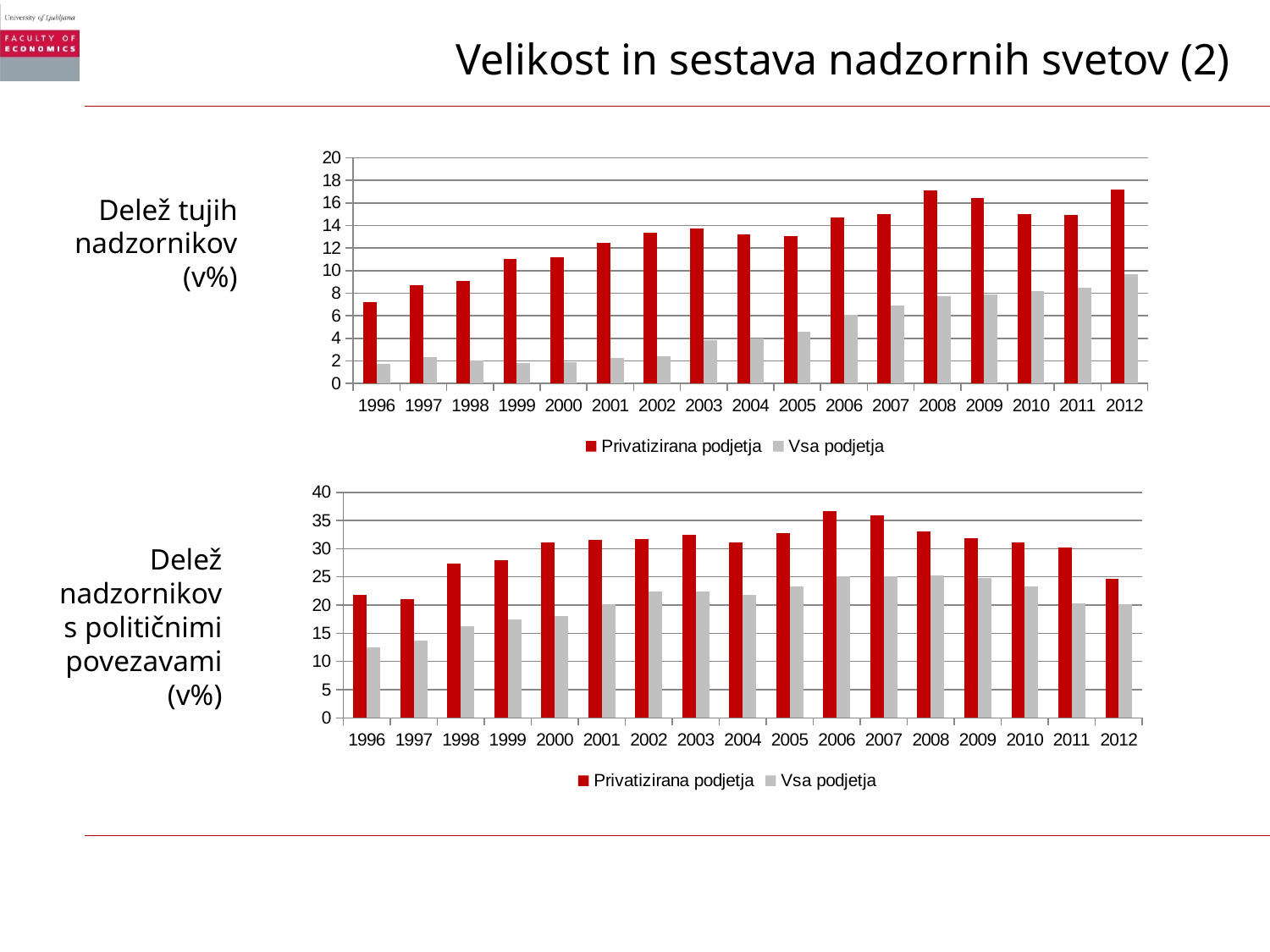
In the top chart (Delež tujih nadzornikov), is the value for Vsa podjetja in 2012 greater or less than 8? greater In the top chart (Delež tujih nadzornikov), do the values for Privatizirana podjetja generally rise or fall from 1996 to 2012? rise How many series does the legend of the bottom chart (Delež nadzornikov s političnimi povezavami) list? 2 In the top chart (Delež tujih nadzornikov), which year has the highest value for Vsa podjetja? 2012 In the top chart (Delež tujih nadzornikov), is the value for Privatizirana podjetja in 1996 greater or less than 8? less In the top chart (Delež tujih nadzornikov), which year has the lowest value for Privatizirana podjetja? 1996 In the bottom chart (Delež nadzornikov s političnimi povezavami), which is larger for Privatizirana podjetja: the value in 2006 or the value in 1996? 2006 How many years are shown on the x axis of the top chart (Delež tujih nadzornikov)? 17 In the top chart (Delež tujih nadzornikov), is the value for Privatizirana podjetja in 2008 greater or less than 16? greater In the bottom chart (Delež nadzornikov s političnimi povezavami), which year has the lowest value for Vsa podjetja? 1996 What kind of chart is the top chart (Delež tujih nadzornikov)? bar chart